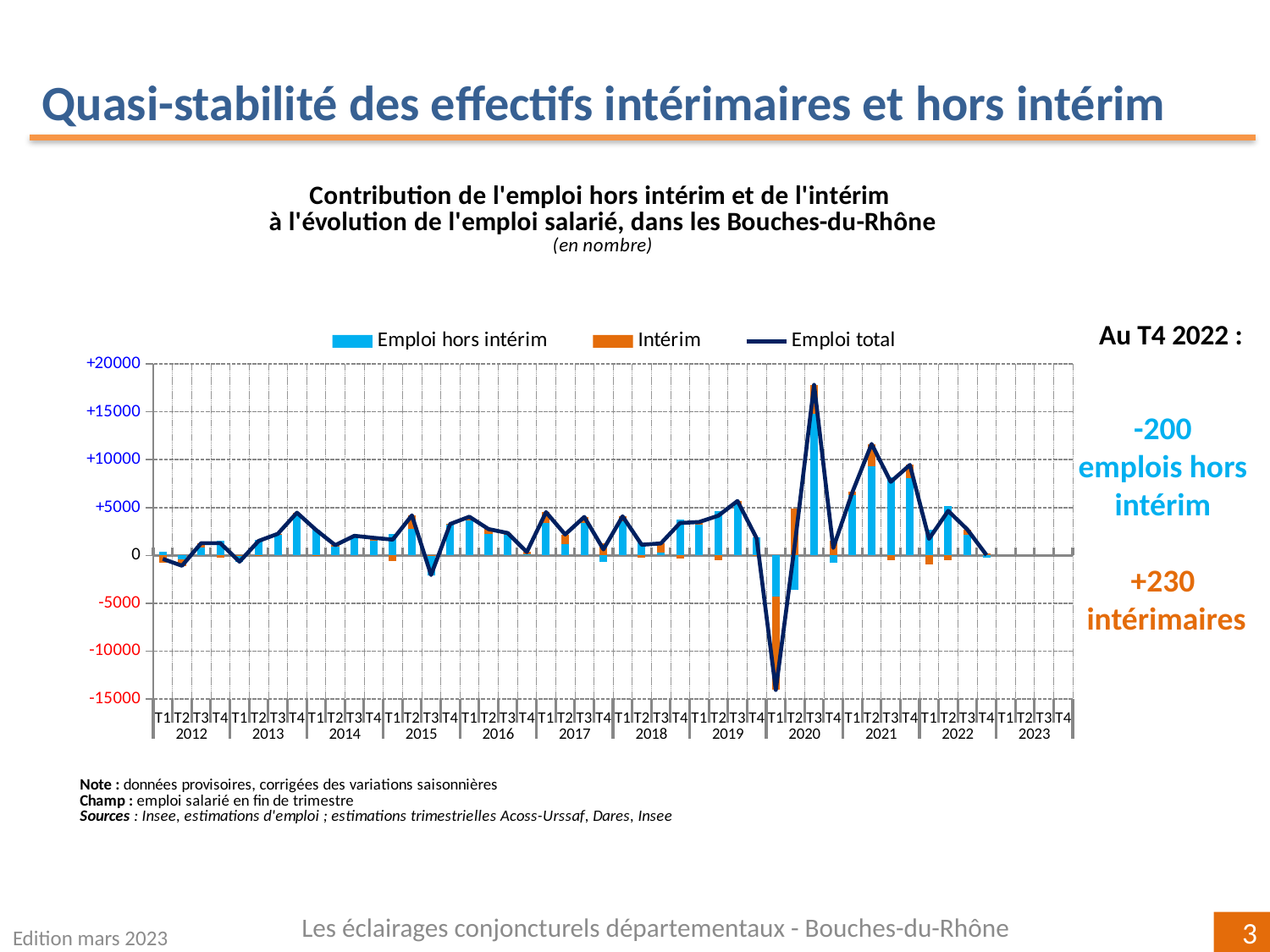
Is the Emploi total value at T1 2020 greater or less than -10000? less According to the slide, what is the value for Emploi hors intérim at T4 2022? -200 Is the Emploi total value at T3 2020 greater or less than +15000? greater Which series is drawn as a line rather than bars? Emploi total What kind of chart is shown on the slide? A combined bar and line chart Which is larger, the Emploi total value at T3 2020 or at T2 2021? T3 2020 According to the slide, what is the value for Intérim at T4 2022? +230 How many years are labelled along the x axis? 12 In which quarter does the Emploi total line reach its lowest value? T1 2020 How many series does the chart legend list? 3 In which quarter does the Emploi total line reach its highest value? T3 2020 What is the title of the chart? Contribution de l'emploi hors intérim et de l'intérim à l'évolution de l'emploi salarié, dans les Bouches-du-Rhône